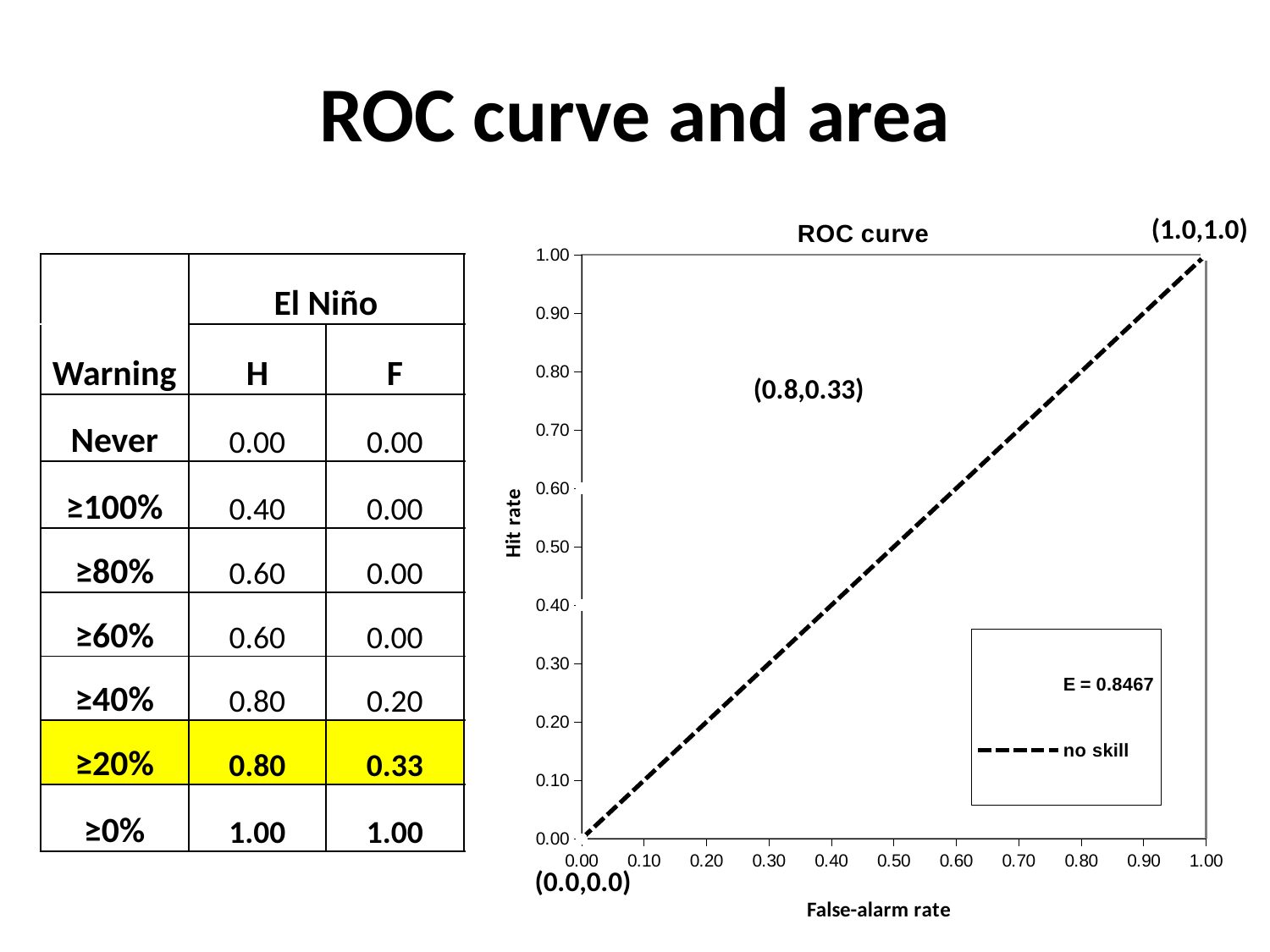
What is the highest value shown on the chart's hit rate axis? 1.00 What is the lowest value shown on the chart's false-alarm rate axis? 0.00 What coordinate pair is annotated in the upper-left area of the chart's plot? (0.8,0.33) What value of E is shown in the chart's legend? E = 0.8467 How many coordinate-pair annotations are written on the chart? 3 Does the 'no skill' line rise or fall as the false-alarm rate increases? rises How many entries does the chart's legend list? 2 At a false-alarm rate of 0.50, what hit rate does the 'no skill' line reach? 0.50 At a false-alarm rate of 0.80, is the hit rate of the 'no skill' line greater or less than 0.50? greater At a false-alarm rate of 0.20, is the hit rate of the 'no skill' line greater or less than 0.50? less What kind of chart is shown on the slide? line chart What is the title of the chart on the slide? ROC curve